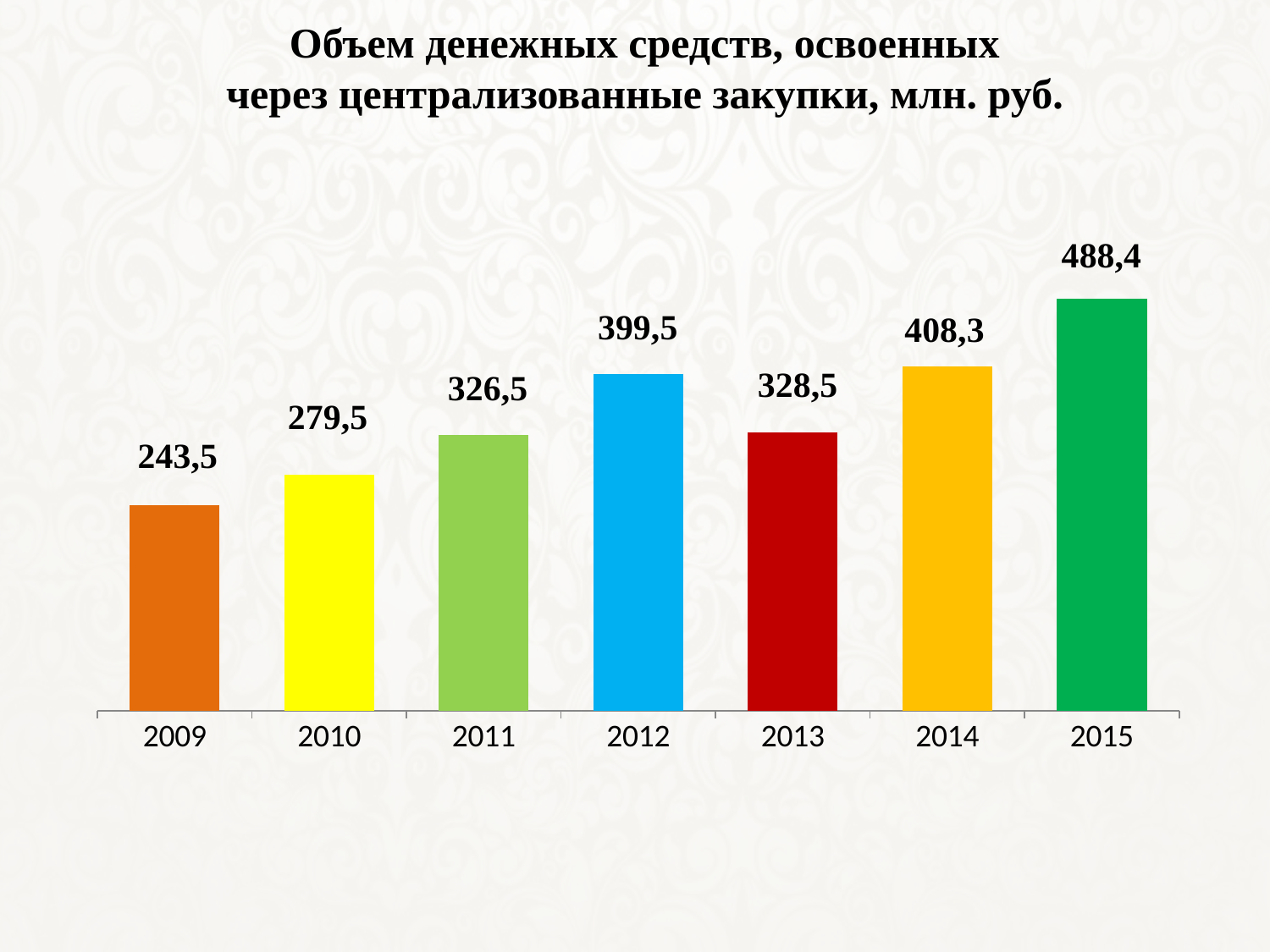
What unit is given in the chart title? млн. руб. What is the value for 2009? 243,5 What is the value for 2014? 408,3 Which year has the lowest value? 2009 Does the value rise or fall from 2012 to 2013? fall What kind of chart is shown on the slide? bar chart What is the difference between the values for 2015 and 2009? 244,9 What is the difference between the values for 2012 and 2013? 71 Which year has the highest value? 2015 What is the value for 2012? 399,5 Which is larger, the value for 2012 or the value for 2013? 2012 How many years are shown on the x axis? 7